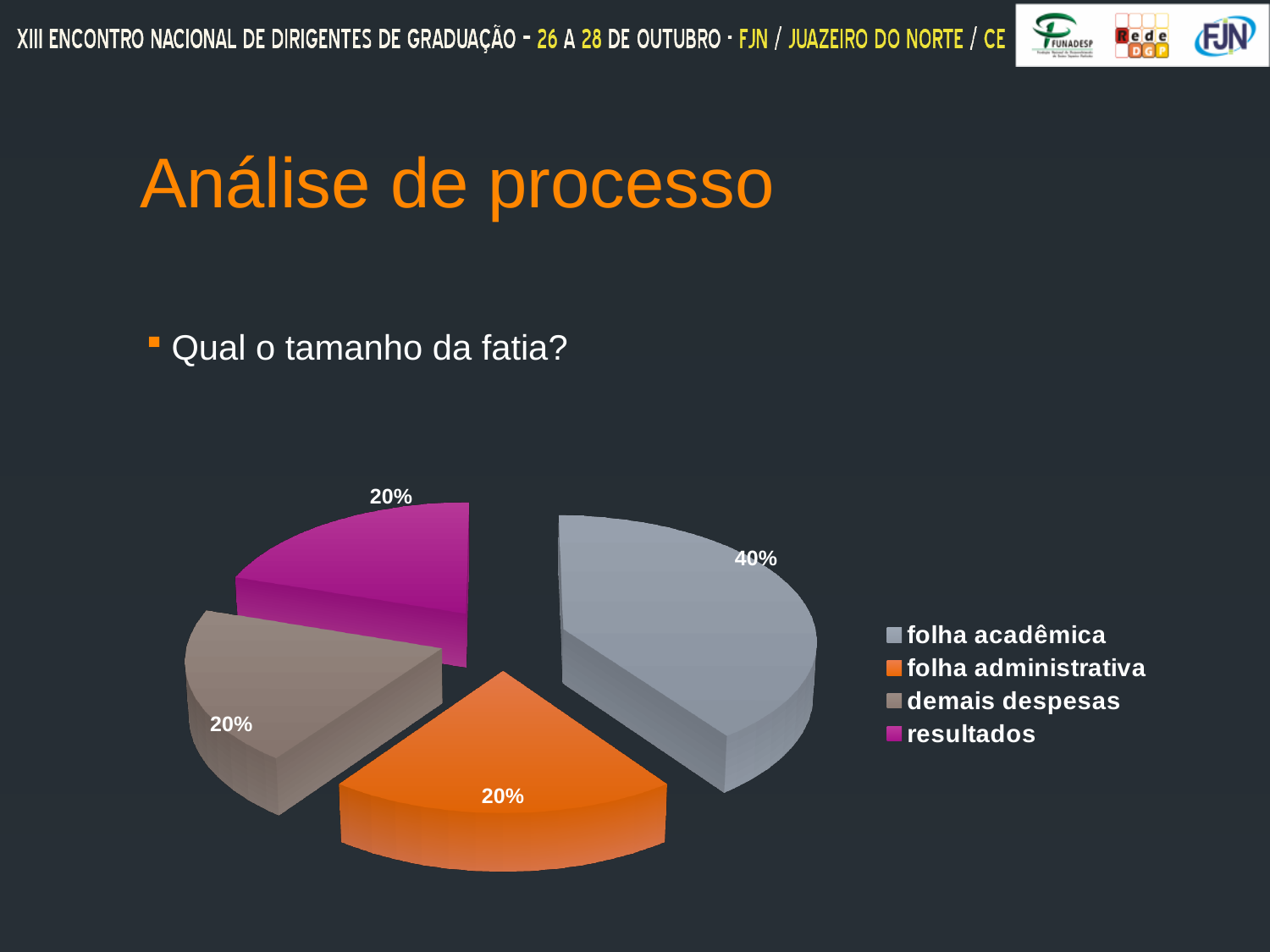
What share of the pie does resultados represent? 20% What kind of chart is shown on the slide? pie chart Which legend entry is shown in orange? folha administrativa What share of the pie does demais despesas represent? 20% What share of the pie does folha administrativa represent? 20% Which is larger, folha acadêmica or resultados? folha acadêmica What is the difference in percentage points between folha acadêmica and folha administrativa? 20% How many entries does the legend list? 4 How many slices does the pie chart have? 4 What colour is the resultados slice in the pie chart? magenta Which slice of the pie is the largest? folha acadêmica What share of the pie does folha acadêmica represent? 40%